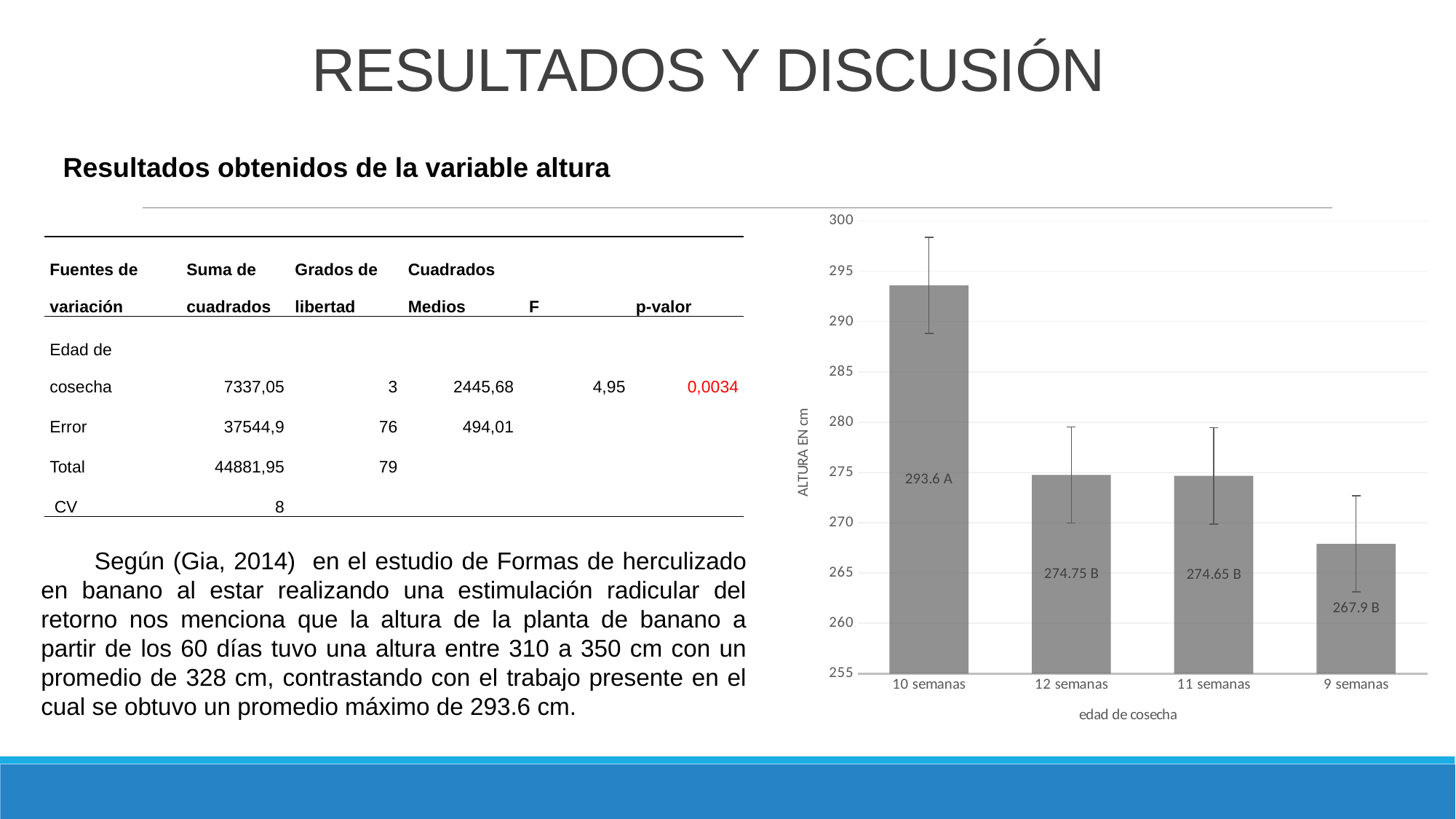
Which is larger, the value for 10 semanas or the value for 12 semanas? 10 semanas What is the value shown for 9 semanas? 267.9 B Which harvest age has the lowest altura? 9 semanas What is the value shown for 12 semanas? 274.75 B Is the value for 9 semanas greater or less than 270? less What is the title of the vertical axis of the chart? ALTURA EN cm How many harvest-age categories are plotted in the chart? 4 What is the value shown for 10 semanas? 293.6 A What is the difference between the values for 10 semanas and 9 semanas? 25.7 Do the bar values rise or fall from left to right along the x axis? fall What kind of chart is shown on the slide? bar chart Which harvest age has the highest altura? 10 semanas